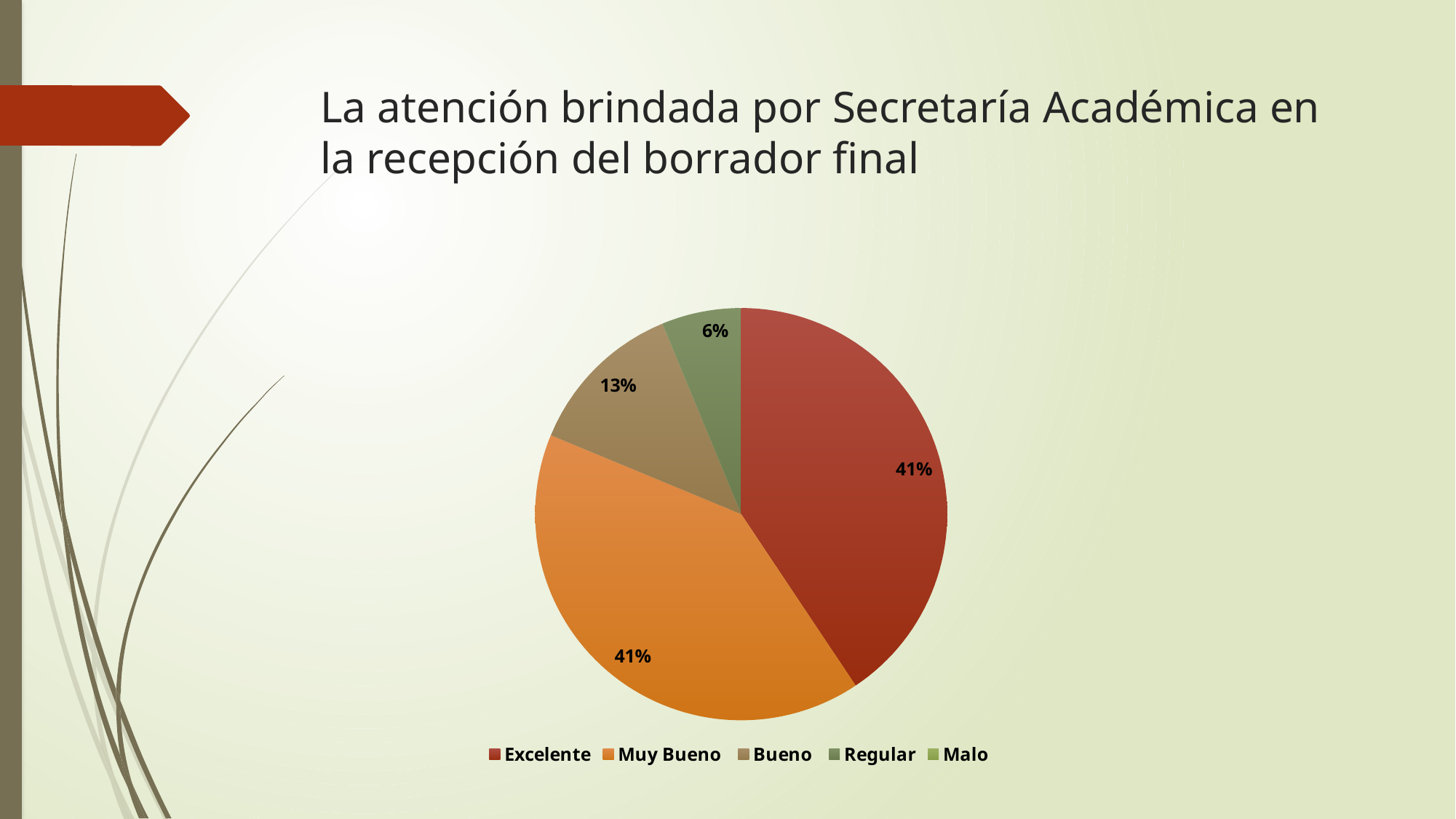
What is the title of the slide containing the chart? La atención brindada por Secretaría Académica en la recepción del borrador final Which is larger, the Excelente slice or the Bueno slice? Excelente What is the difference in percentage points between the Excelente and Bueno slices? 28 What is the difference in percentage points between the Bueno and Regular slices? 7 How many entries does the legend list? 5 What is the value shown for Regular? 6% Which legend entry is shown in red? Excelente What is the value shown for Bueno? 13% What share of the pie does the Muy Bueno slice represent? 41% What kind of chart is shown on the slide? pie chart Which is larger, the Bueno slice or the Regular slice? Bueno What share of the pie does the Excelente slice represent? 41%